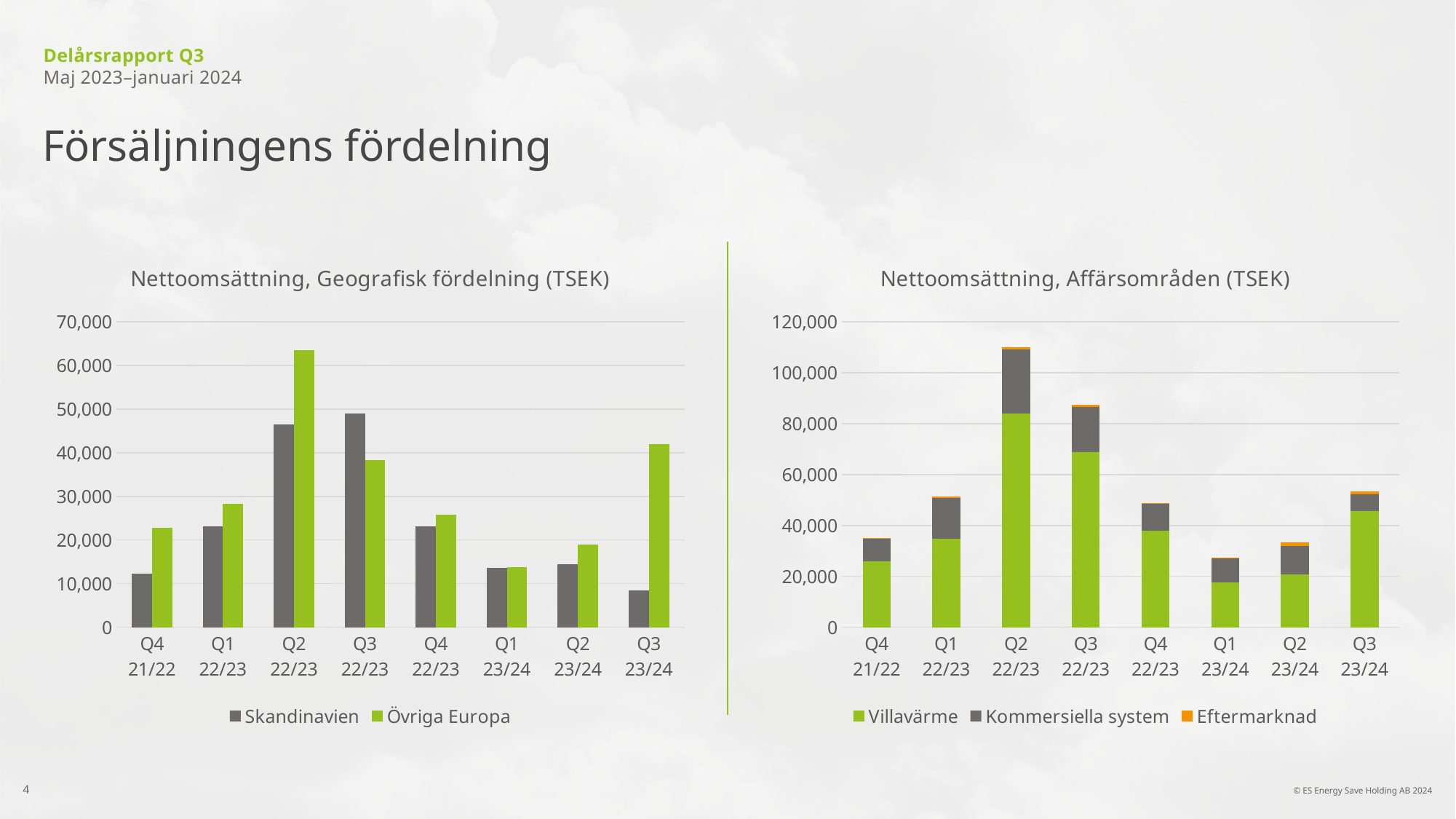
In the right chart, 'Nettoomsättning, Affärsområden (TSEK)', which series is shown in orange? Eftermarknad In the left chart, 'Nettoomsättning, Geografisk fördelning (TSEK)', in which quarter is Skandinavien lowest? Q3 23/24 In the left chart, 'Nettoomsättning, Geografisk fördelning (TSEK)', in which quarter is Övriga Europa highest? Q2 22/23 In the right chart, 'Nettoomsättning, Affärsområden (TSEK)', is the value for Villavärme in Q2 22/23 greater or less than 80,000? greater In the right chart, 'Nettoomsättning, Affärsområden (TSEK)', which quarter has the lowest total bar? Q1 23/24 How many quarters are shown on the x axis of the left chart, 'Nettoomsättning, Geografisk fördelning (TSEK)'? 8 In the left chart, 'Nettoomsättning, Geografisk fördelning (TSEK)', is the value for Skandinavien in Q3 23/24 greater or less than 10,000? less In the left chart, 'Nettoomsättning, Geografisk fördelning (TSEK)', which is larger in Q3 23/24: Skandinavien or Övriga Europa? Övriga Europa How many series does the legend of the right chart, 'Nettoomsättning, Affärsområden (TSEK)', list? 3 In the left chart, 'Nettoomsättning, Geografisk fördelning (TSEK)', is the value for Övriga Europa in Q2 22/23 greater or less than 60,000? greater What type of chart is the left chart, 'Nettoomsättning, Geografisk fördelning (TSEK)'? Bar chart In the right chart, 'Nettoomsättning, Affärsområden (TSEK)', which quarter has the highest total bar? Q2 22/23